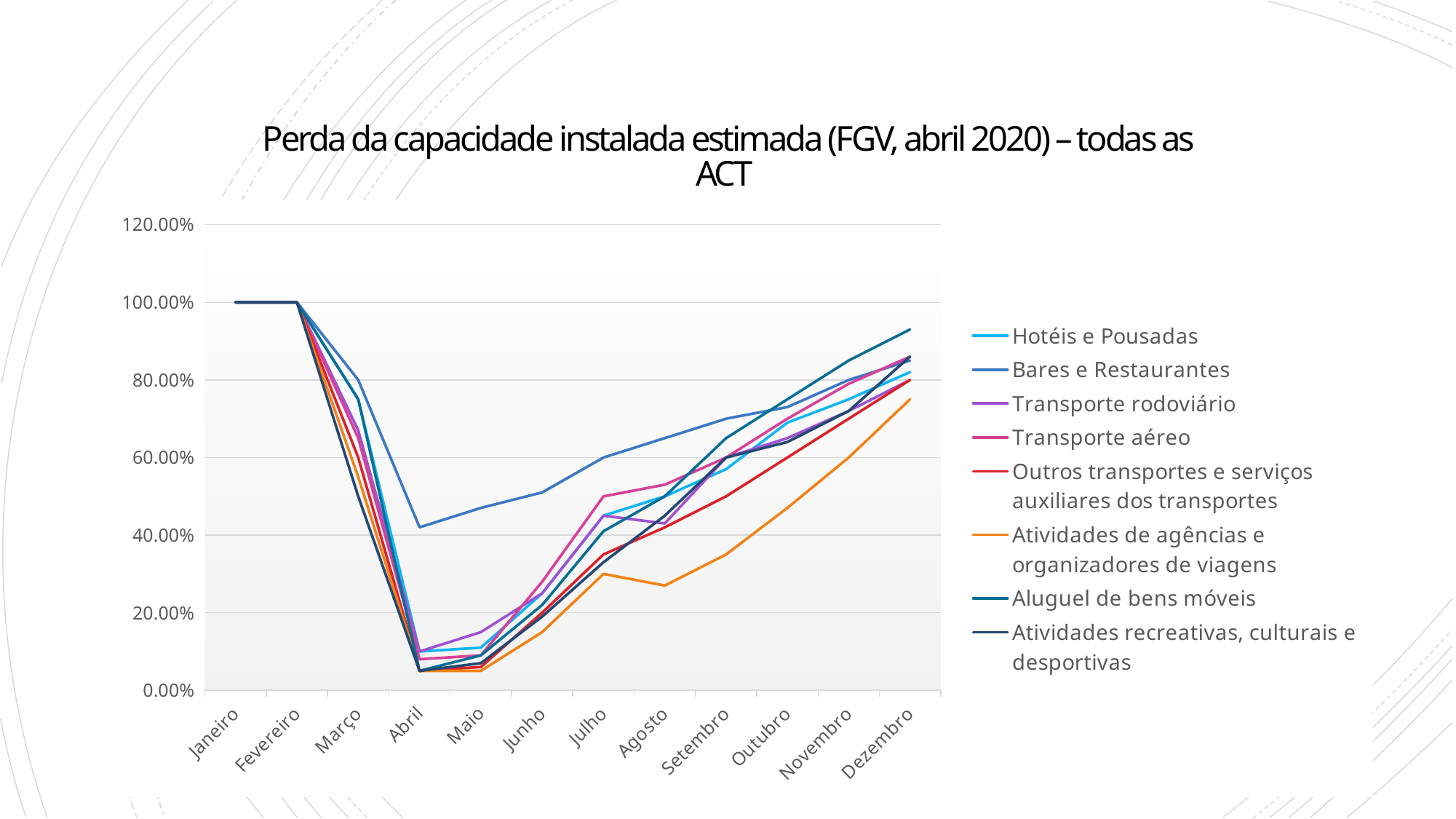
Is the value for Aluguel de bens móveis in Dezembro greater or less than 80.00%? greater What is the value for Hotéis e Pousadas in Janeiro? 100.00% Which series has the highest value in Abril? Bares e Restaurantes Which series has the highest value in Dezembro? Aluguel de bens móveis Is the value for Atividades de agências e organizadores de viagens in Agosto greater or less than 40.00%? less In Julho, which is higher: Bares e Restaurantes or Atividades de agências e organizadores de viagens? Bares e Restaurantes Do the values for Aluguel de bens móveis rise or fall from Abril to Dezembro? rise How many series does the legend list? 8 How many months are shown along the x axis? 12 What kind of chart is shown on the slide? line chart Which series has the lowest value in Dezembro? Atividades de agências e organizadores de viagens Is the value for Bares e Restaurantes in Abril greater or less than 60.00%? less